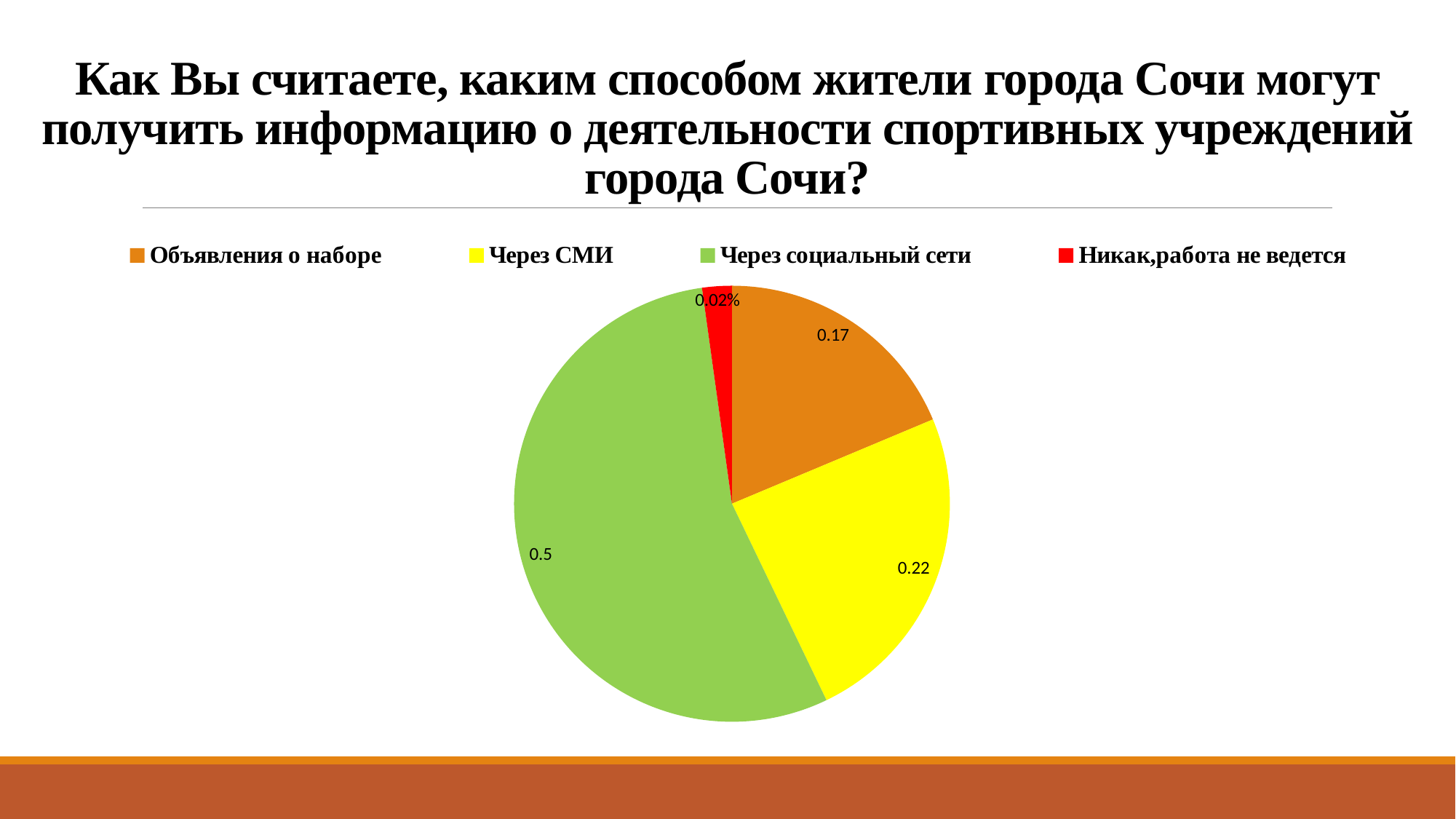
What value is shown for the slice "Через социальный сети"? 0.5 Which is larger, the slice for "Через СМИ" or the slice for "Объявления о наборе"? Через СМИ What value is shown for the slice "Через СМИ"? 0.22 What label is printed on the slice "Никак,работа не ведется"? 0.02% What value is shown for the slice "Объявления о наборе"? 0.17 What is the difference between the values for "Через СМИ" and "Объявления о наборе"? 0.05 What kind of chart is shown on the slide? Pie chart Which category has the largest slice of the pie? Через социальный сети How many slices does the pie chart have? 4 What colour is the slice for "Через социальный сети"? Green Which category has the smallest slice of the pie? Никак,работа не ведется What is the difference between the values for "Через социальный сети" and "Через СМИ"? 0.28